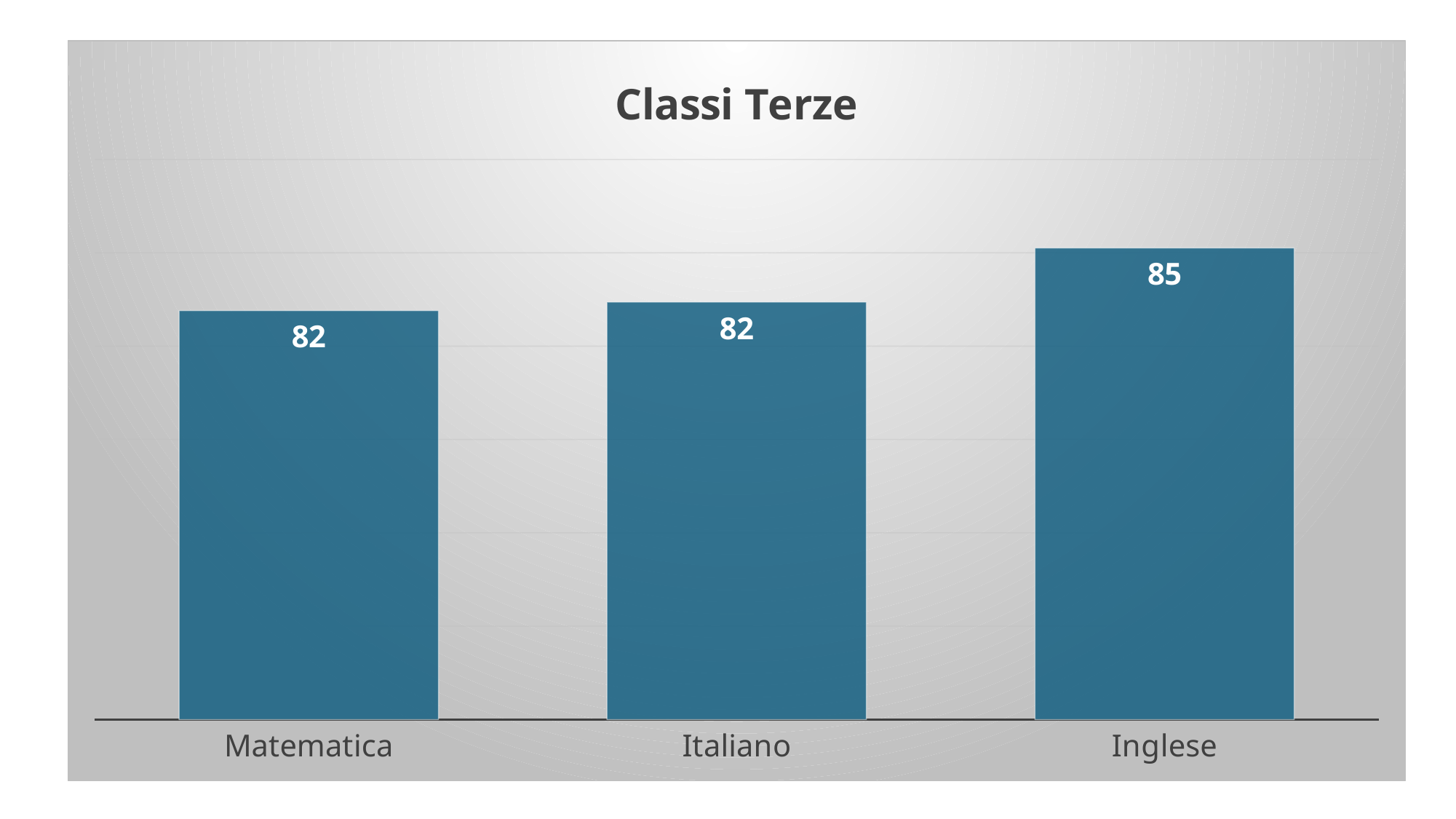
Which category has the highest value? Inglese What is the difference between the values for Italiano and Matematica? 0 What colour are the bars in the chart? Blue How many categories are shown on the chart? 3 What is the title of the chart? Classi Terze What kind of chart is shown on the slide? Bar chart What is the value for Italiano? 82 What is the value for Matematica? 82 What is the difference between the values for Inglese and Matematica? 3 Which is larger, the value for Inglese or the value for Italiano? Inglese What is the value for Inglese? 85